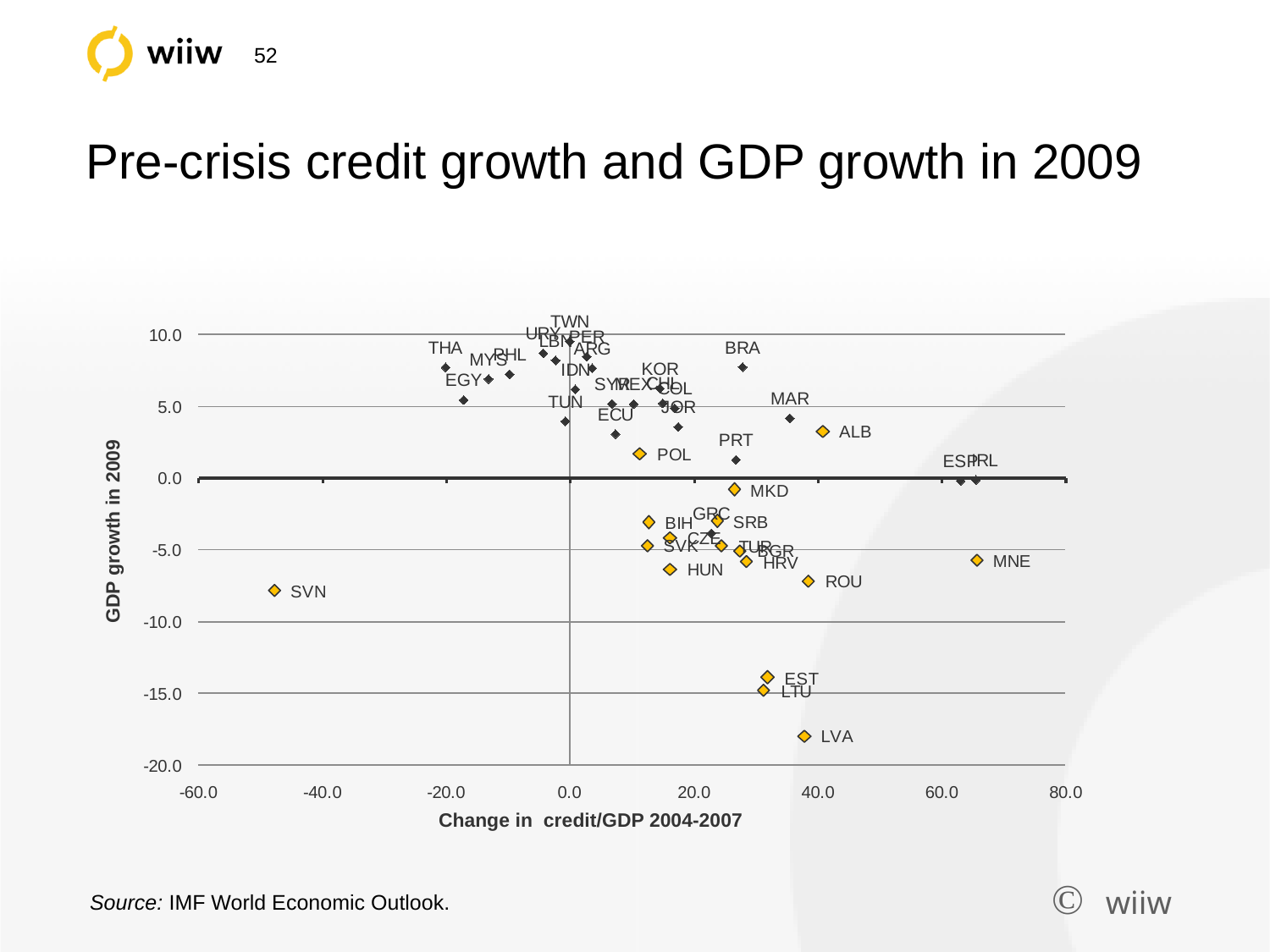
Is the GDP growth in 2009 for ALB greater or less than 0.0? greater Is the change in credit/GDP 2004-2007 for SVN greater or less than -40.0? less Is the change in credit/GDP 2004-2007 for MNE greater or less than 60.0? greater What is the label of the horizontal axis of the chart? Change in credit/GDP 2004-2007 Which country has the lowest change in credit/GDP 2004-2007 on the chart? SVN Which country has the higher GDP growth in 2009, EST or LVA? EST Which country has the lowest GDP growth in 2009 on the chart? LVA Which country has the larger change in credit/GDP 2004-2007, SVN or MNE? MNE What is the title of the chart? Pre-crisis credit growth and GDP growth in 2009 What kind of chart is shown on the slide? scatter chart